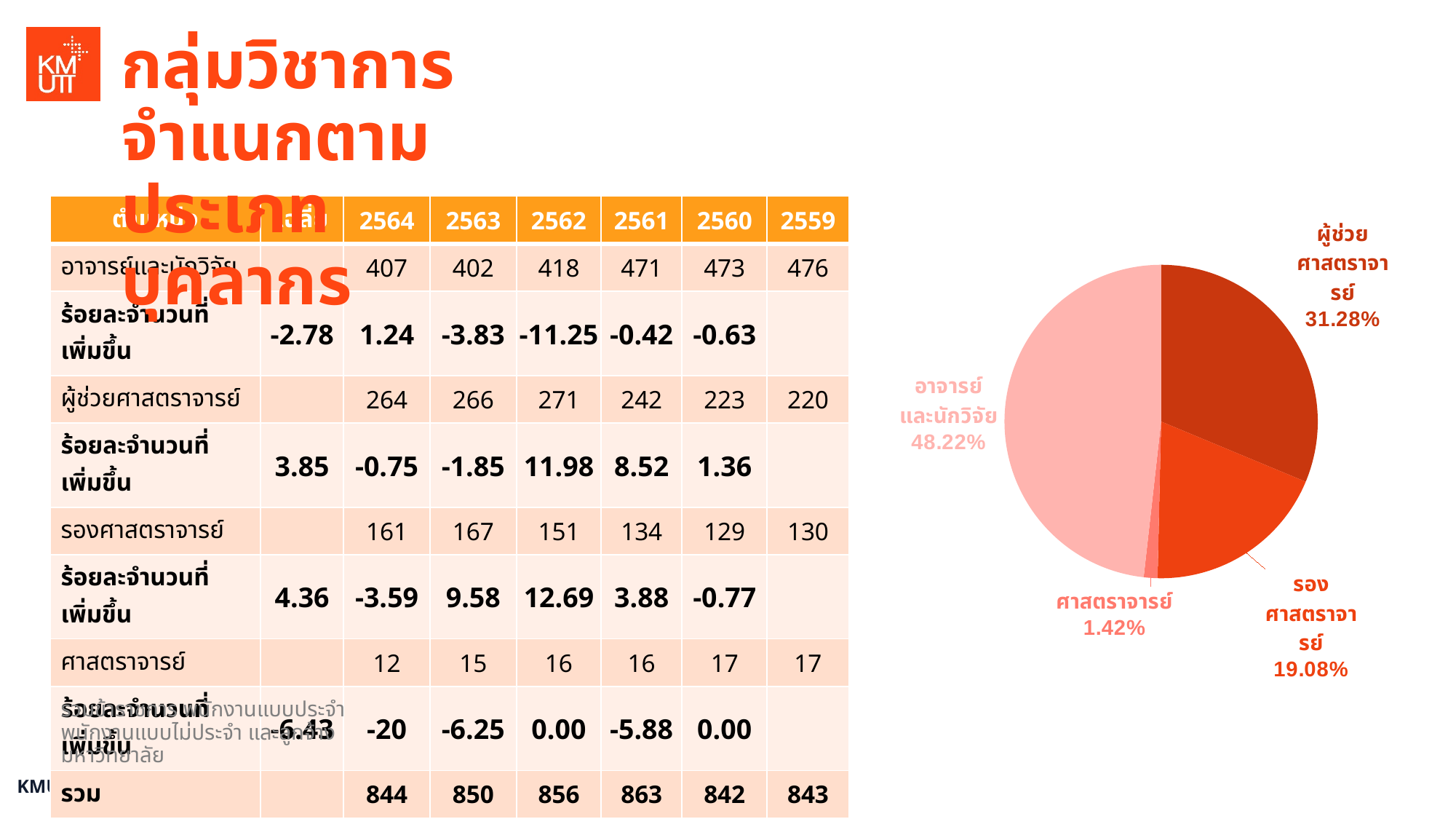
Which slice of the pie chart is drawn in the darkest red colour? ผู้ช่วยศาสตราจารย์ What is the difference in percentage points between อาจารย์และนักวิจัย and ผู้ช่วยศาสตราจารย์ in the pie chart? 16.94 What kind of chart is shown on the right of the slide? Pie chart Which category has the smallest slice in the pie chart? ศาสตราจารย์ How many slices does the pie chart have? 4 What share of the pie chart does ศาสตราจารย์ represent? 1.42% What share of the pie chart does ผู้ช่วยศาสตราจารย์ represent? 31.28% Which category has the largest slice in the pie chart? อาจารย์และนักวิจัย In the pie chart, which is larger: ผู้ช่วยศาสตราจารย์ or รองศาสตราจารย์? ผู้ช่วยศาสตราจารย์ What share of the pie chart does รองศาสตราจารย์ represent? 19.08% What is the difference in percentage points between รองศาสตราจารย์ and ศาสตราจารย์ in the pie chart? 17.66